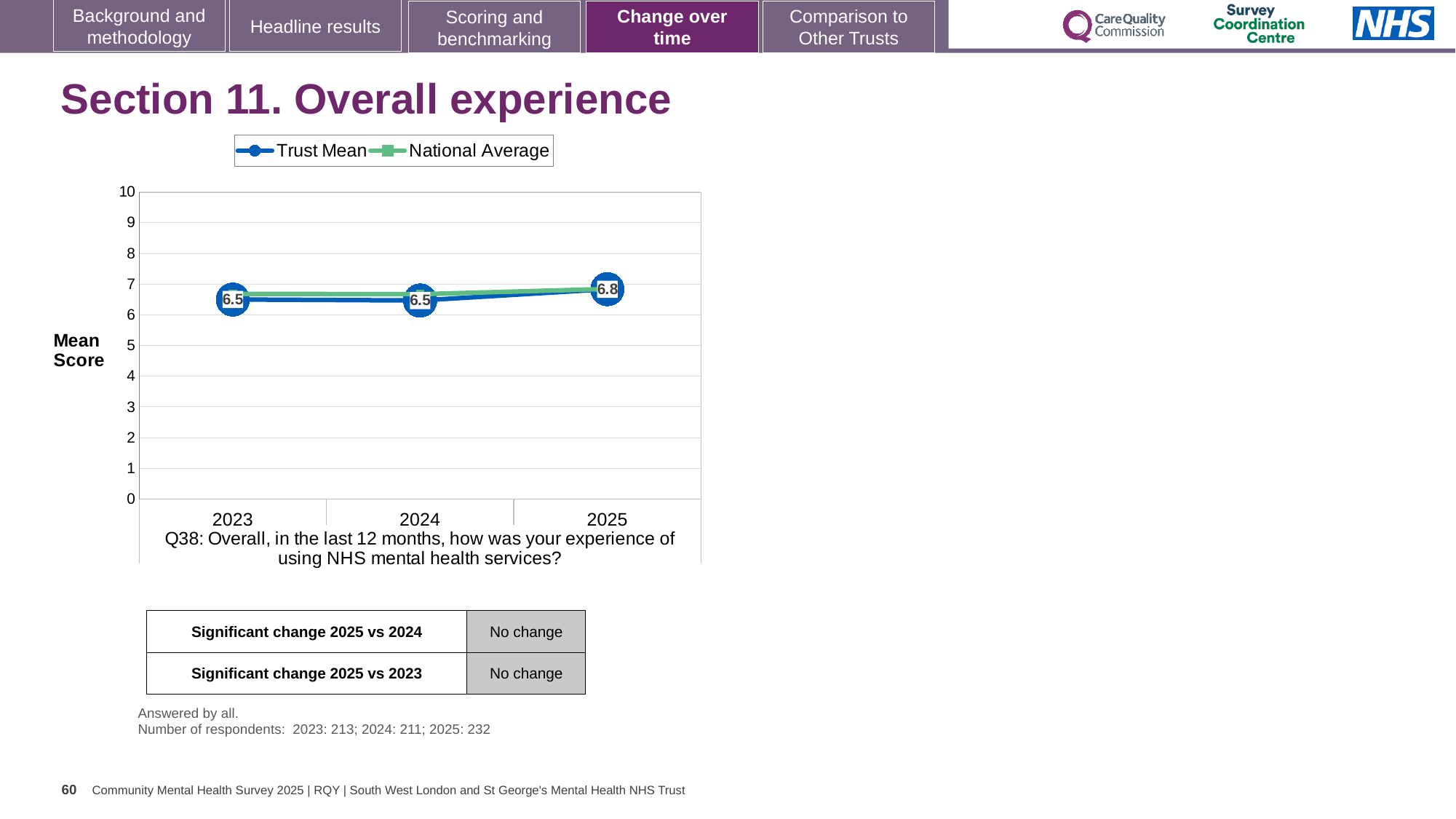
Does the Trust Mean score rise or fall from 2024 to 2025? rise Is the National Average value for 2023 greater or less than 5? greater How many years are plotted on the x axis of the chart? 3 How many series does the chart legend list? 2 What is the label of the y axis of the chart? Mean Score What is the difference between the Trust Mean score in 2025 and in 2023? 0.3 What is the Trust Mean score for 2025? 6.8 What is the Trust Mean score for 2023? 6.5 What is the Trust Mean score for 2024? 6.5 In which year is the Trust Mean score highest? 2025 What kind of chart is shown on the slide? line chart Which is larger, the Trust Mean score for 2025 or for 2024? 2025